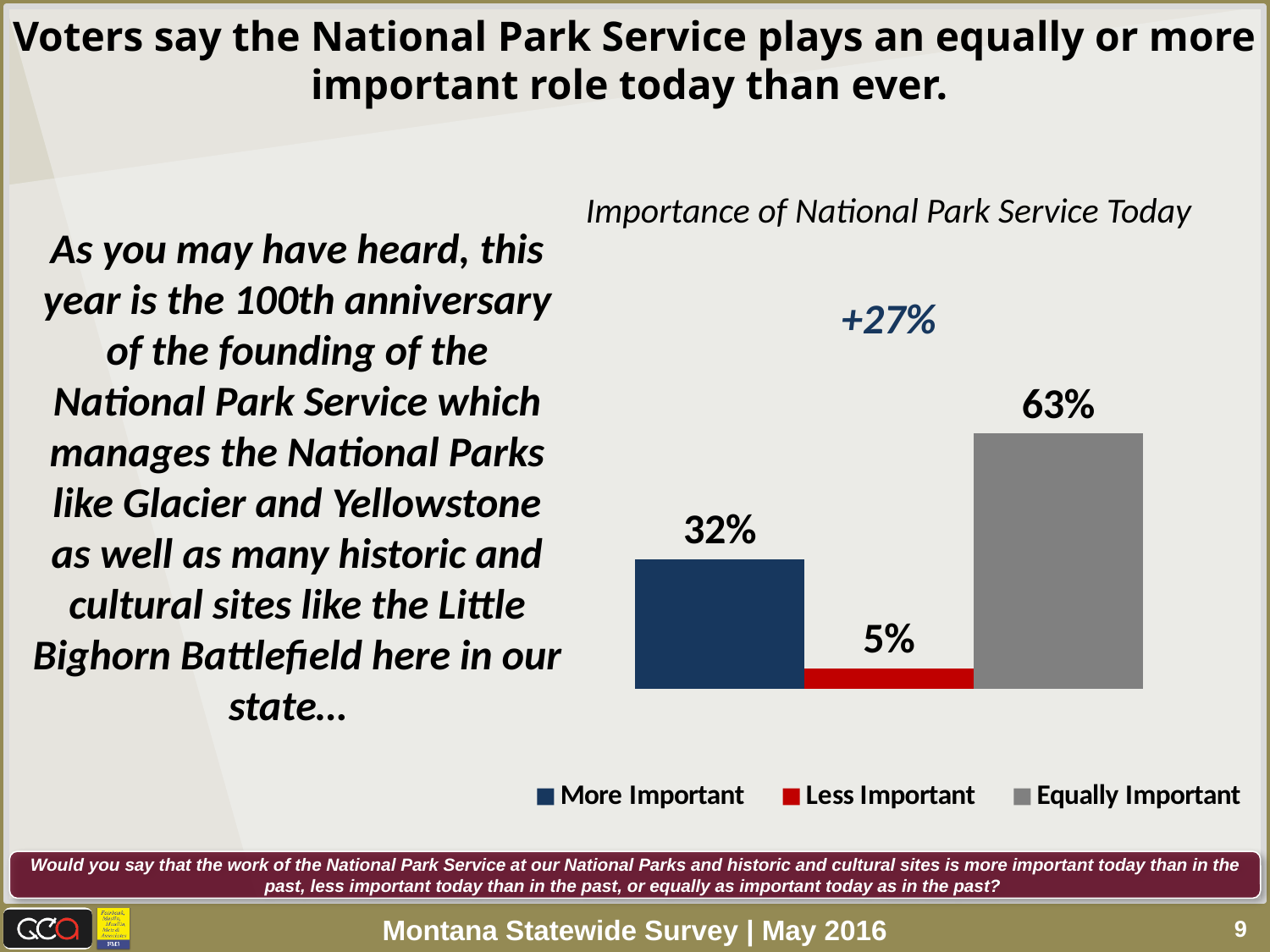
How many series does the legend list? 3 What colour is the bar for Less Important? Red What is the difference between the More Important and Less Important percentages? 27% What percentage of voters say the National Park Service is More Important today? 32% Which response has the lowest percentage in the chart? Less Important What percentage of voters say the National Park Service is Less Important today? 5% What is the difference between the Equally Important and More Important percentages? 31% What percentage of voters say the National Park Service is Equally Important today? 63% Which response has the highest percentage in the chart? Equally Important Which is larger, the percentage for More Important or for Less Important? More Important What kind of chart is shown on the slide? Bar chart What is the title of the chart? Importance of National Park Service Today